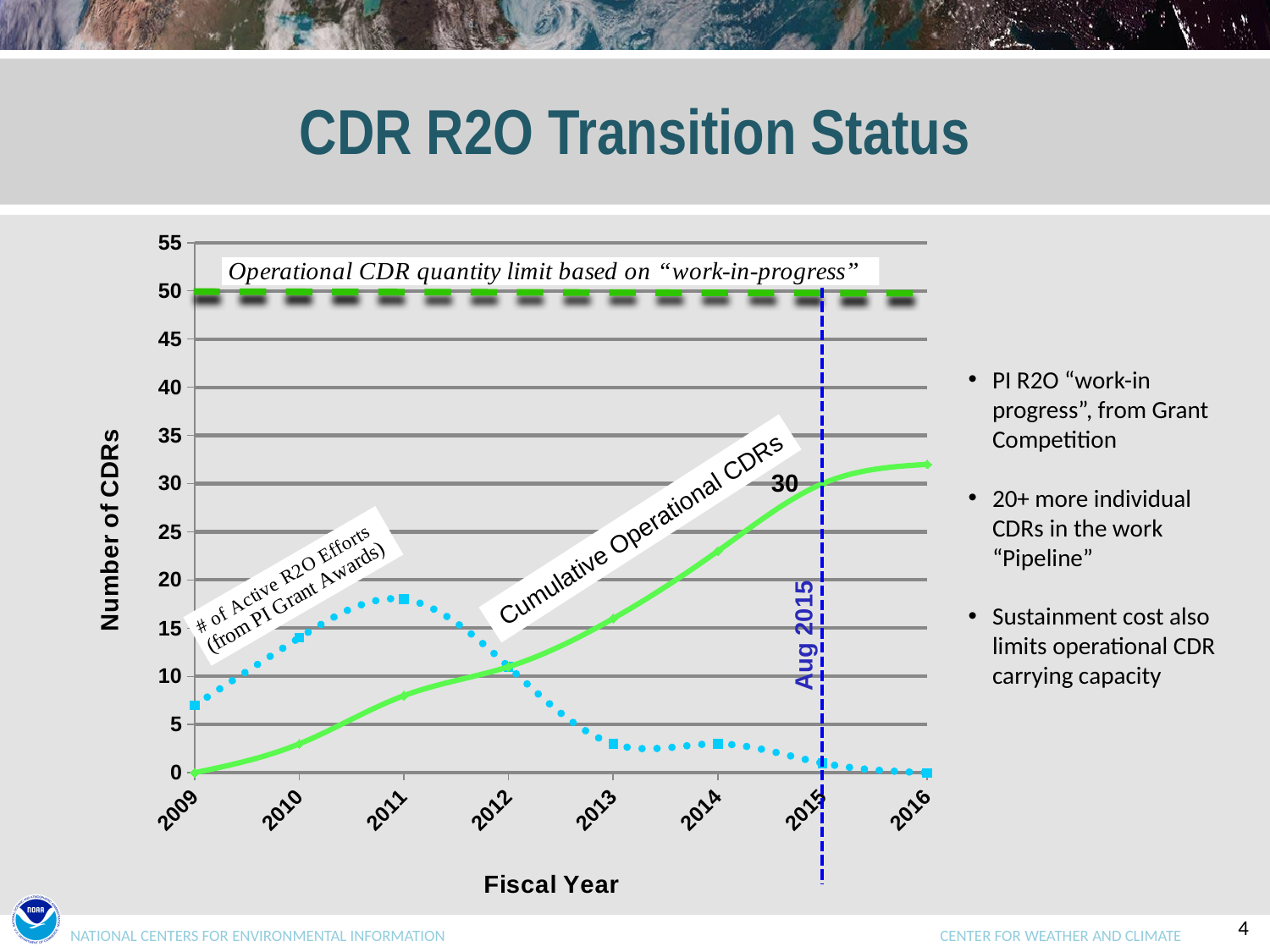
What kind of chart is shown on the slide? line chart In 2014, which is larger: Cumulative Operational CDRs or # of Active R2O Efforts? Cumulative Operational CDRs Do the Cumulative Operational CDRs rise or fall from 2009 to 2016? rise How many fiscal years are labelled on the x axis? 8 In 2011, which is larger: Cumulative Operational CDRs or # of Active R2O Efforts? # of Active R2O Efforts What is the value of Cumulative Operational CDRs in fiscal year 2015? 30 What is the value of Cumulative Operational CDRs in fiscal year 2009? 0 At what value is the dashed line for the Operational CDR quantity limit drawn? 50 Does the number of Active R2O Efforts rise or fall from 2011 to 2016? fall Is the number of Active R2O Efforts in 2011 greater or less than 15? greater Is the number of Active R2O Efforts in 2014 greater or less than 5? less Is the value of Cumulative Operational CDRs in 2013 greater or less than 20? less